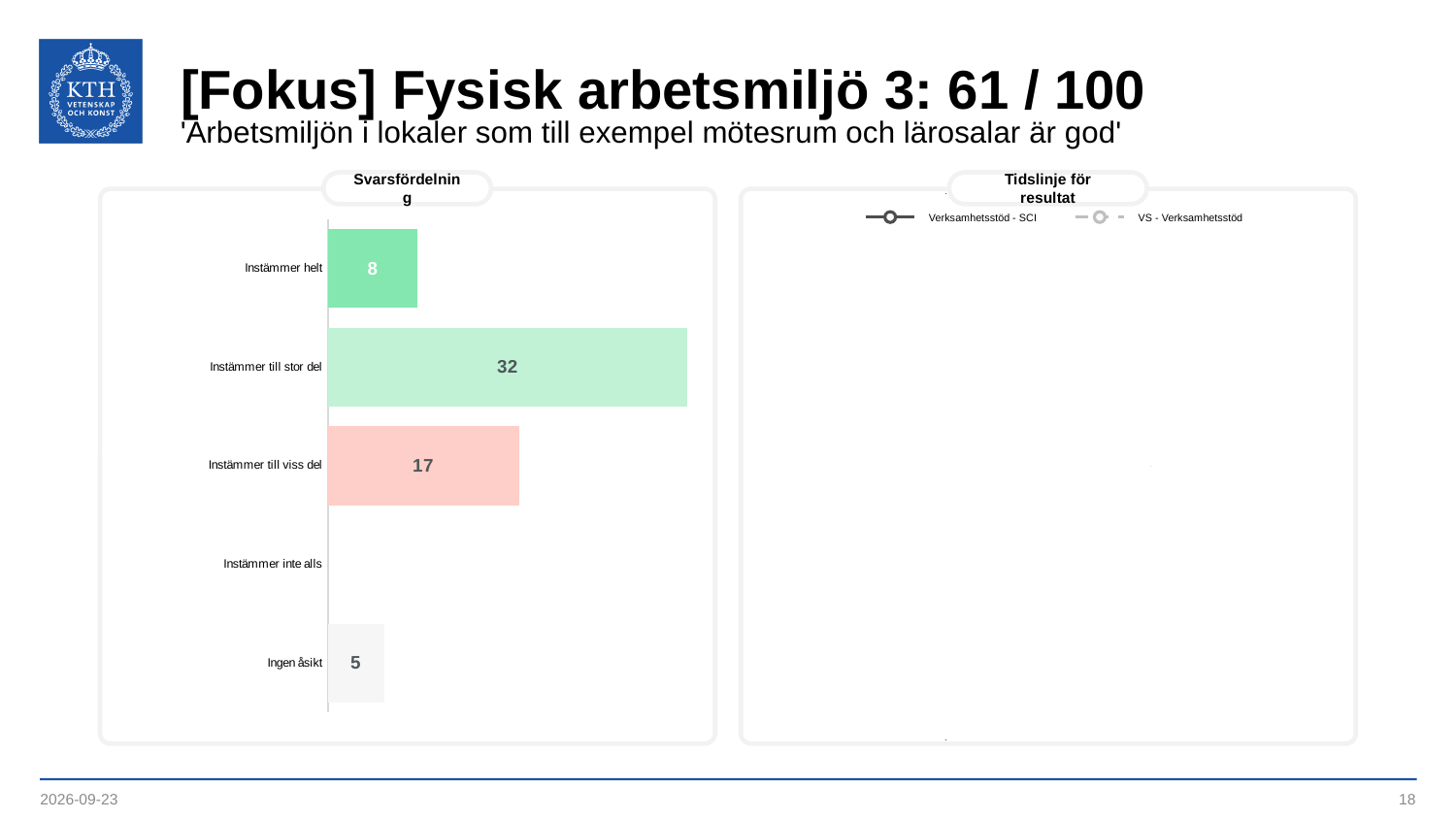
How many categories are shown in the Svarsfördelning chart? 5 In the Svarsfördelning chart, what is the difference between Instämmer helt and Ingen åsikt? 3 What is the first legend entry in the Tidslinje för resultat chart? Verksamhetsstöd - SCI What kind of chart is the Svarsfördelning chart? Bar chart In the Svarsfördelning chart, which category has the highest value? Instämmer till stor del How many series does the legend of the Tidslinje för resultat chart list? 2 In the Svarsfördelning chart, what is the value for Instämmer till viss del? 17 In the Svarsfördelning chart, what is the value for Ingen åsikt? 5 In the Svarsfördelning chart, which is larger, Instämmer till viss del or Instämmer helt? Instämmer till viss del In the Svarsfördelning chart, what is the value for Instämmer till stor del? 32 In the Svarsfördelning chart, what is the difference between Instämmer till stor del and Instämmer till viss del? 15 In the Svarsfördelning chart, what is the value for Instämmer helt? 8